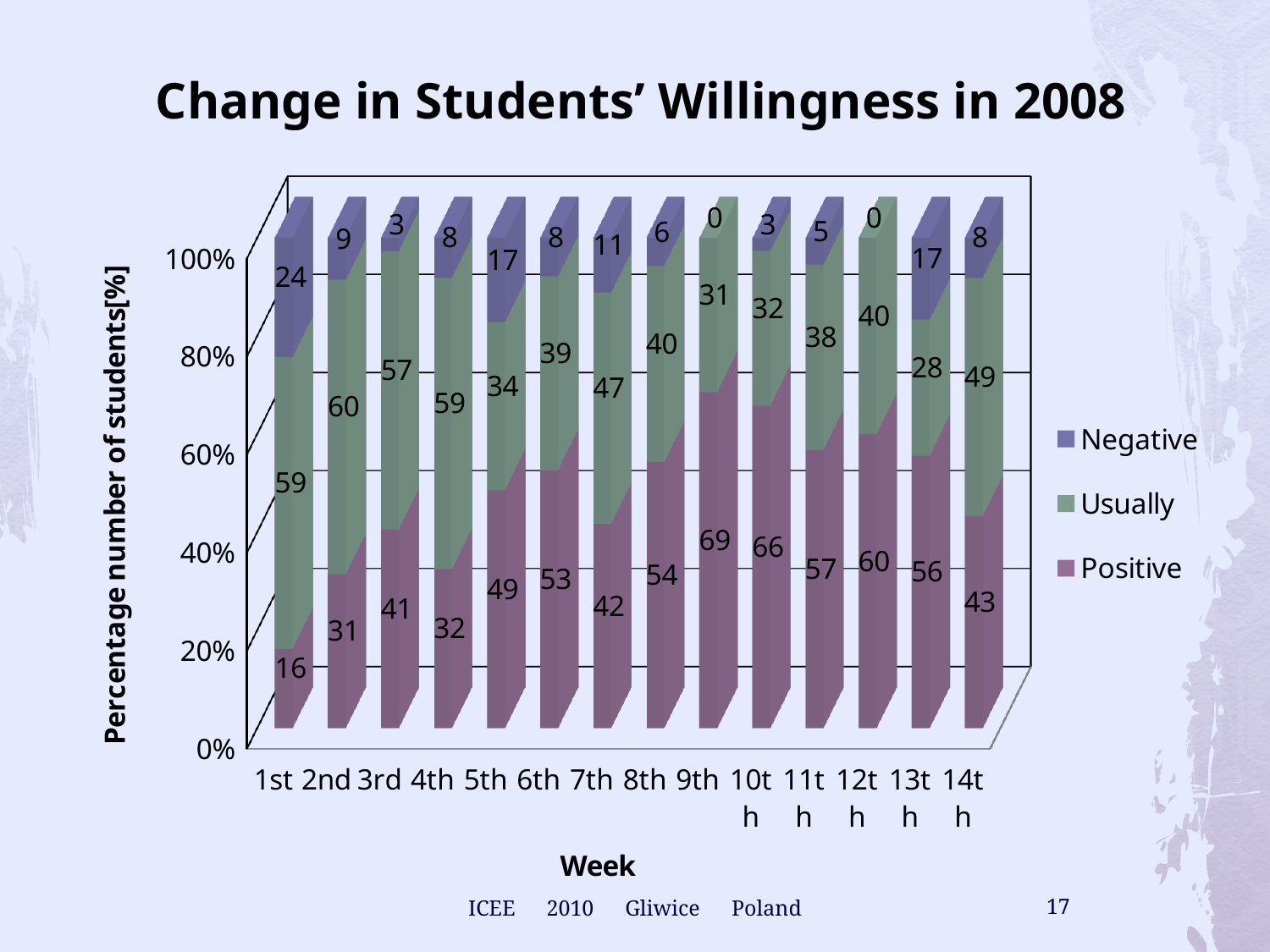
What is the Usually value for the 14th week? 49 Which week has the highest Negative value? 1st What is the Negative value for the 1st week? 24 Which is larger, the Usually value for the 2nd week or the Usually value for the 5th week? 2nd week What kind of chart is shown on the slide? Stacked bar chart Which week has the highest Positive value? 9th How many series does the legend list? 3 What is the difference between the Positive values for the 9th week and the 1st week? 53 What is the title of the chart? Change in Students' Willingness in 2008 How many weeks are shown on the x axis? 14 Which week has the lowest Positive value? 1st What is the Positive value for the 9th week? 69